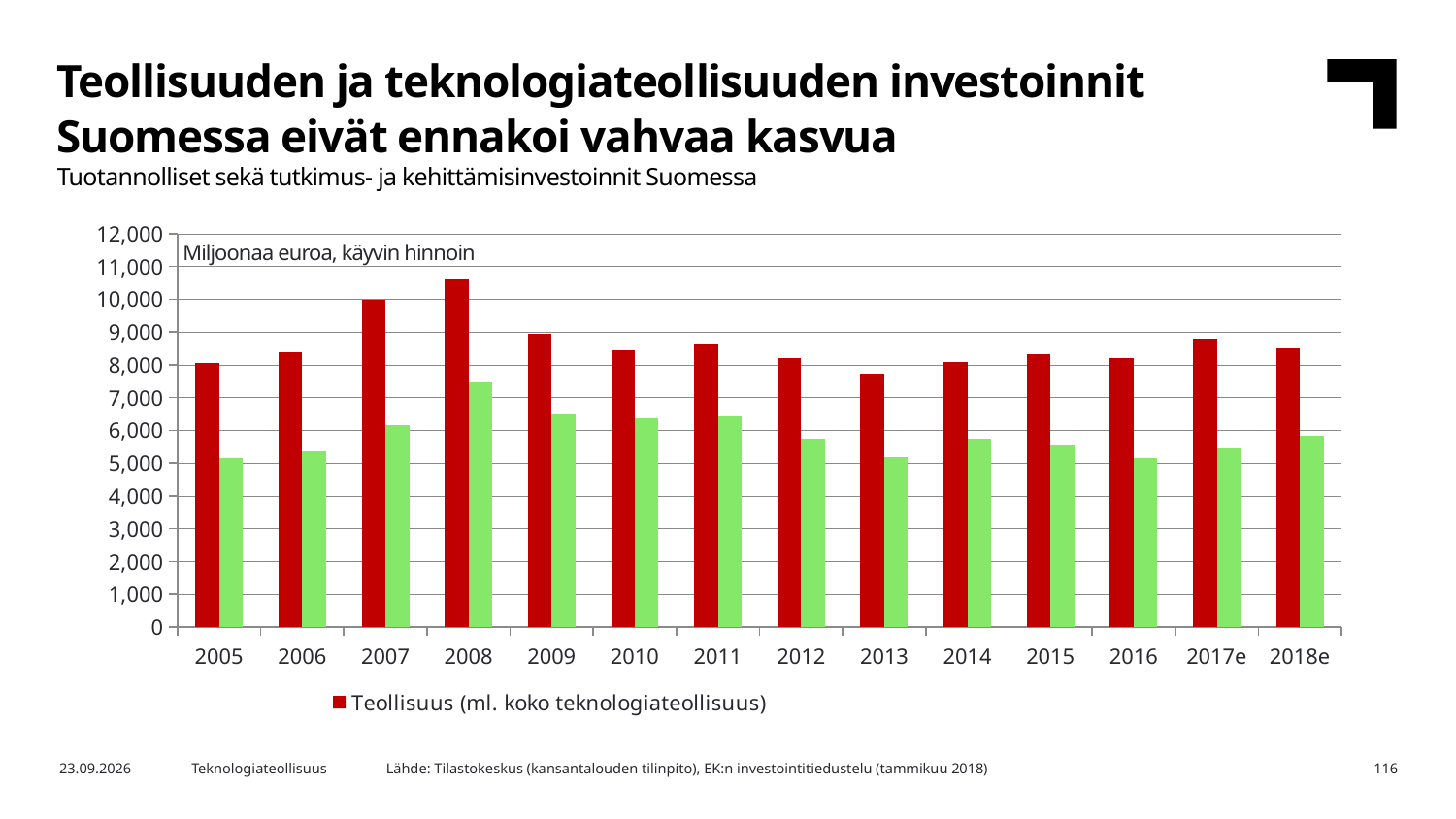
Is the green bar value for 2008 greater or less than 7,000? greater In which year is the green bar highest? 2008 Is the red Teollisuus value for 2013 greater or less than 8,000? less What unit is stated in the text box inside the chart area? Miljoonaa euroa, käyvin hinnoin In which year is the red Teollisuus bar highest? 2008 Do the red Teollisuus bars rise or fall from 2005 to 2008? rise How many series does the legend list? 1 What kind of chart is shown on the slide? bar chart Which year has the larger red Teollisuus bar, 2007 or 2008? 2008 How many years (categories) are shown on the x axis? 14 In which year is the red Teollisuus bar lowest? 2013 Is the red Teollisuus value for 2008 greater or less than 10,000? greater